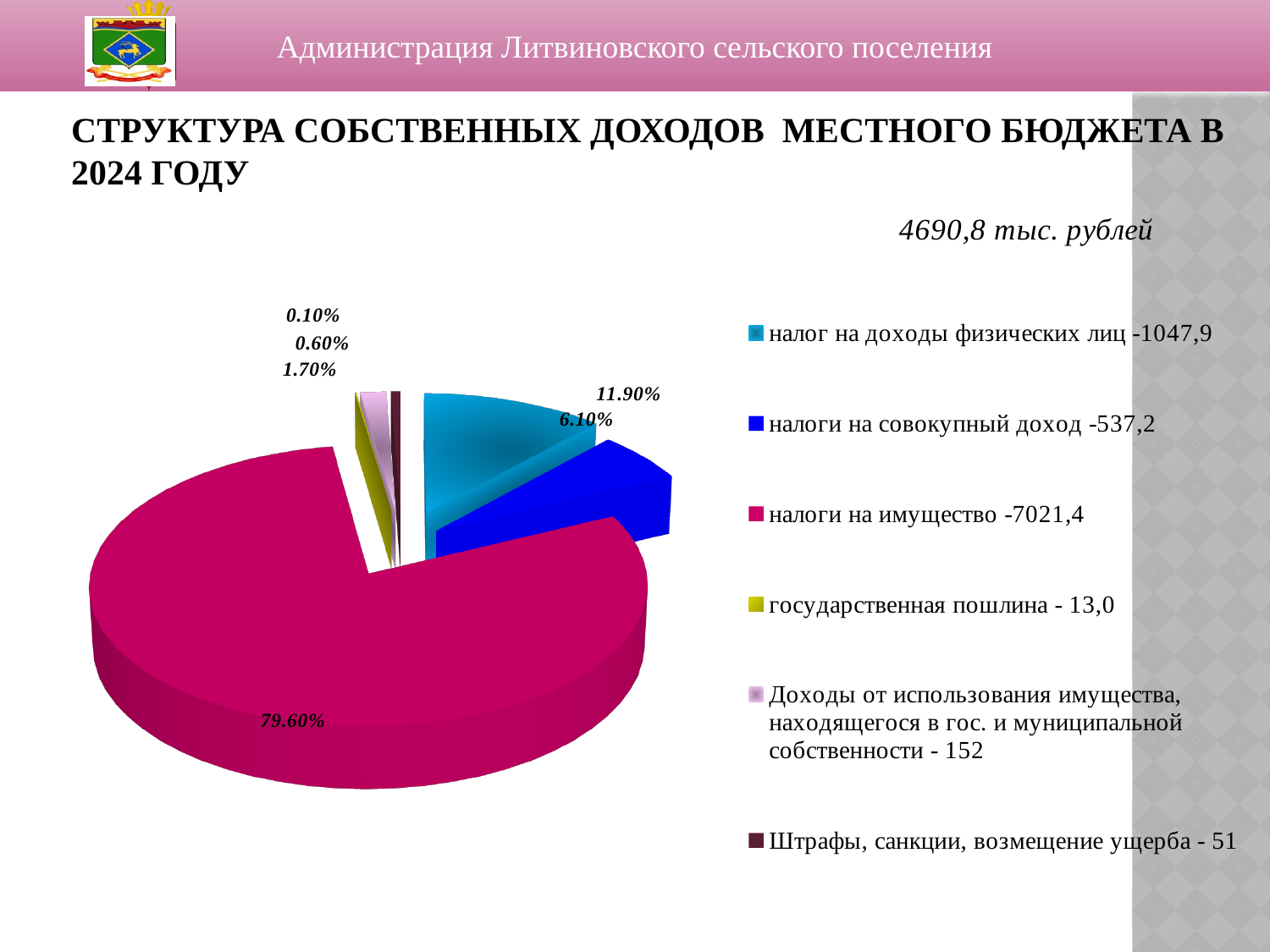
What value is given in the legend for "государственная пошлина"? 13,0 What share of the pie does "налоги на имущество" take? 79.60% How many slices does the pie chart have? 6 What is the difference in percentage points between the "налоги на имущество" slice and the "налог на доходы физических лиц" slice? 67.70% Which slice is larger: "налоги на совокупный доход" or "налог на доходы физических лиц"? налог на доходы физических лиц Which category has the smallest slice of the pie? государственная пошлина What total amount in thousand rubles is stated above the chart? 4690,8 тыс. рублей What share of the pie does "налоги на совокупный доход" take? 6.10% What share of the pie does "налог на доходы физических лиц" take? 11.90% What kind of chart is shown on the slide? pie chart What value is given in the legend for "налог на доходы физических лиц"? 1047,9 Which category has the largest slice of the pie? налоги на имущество